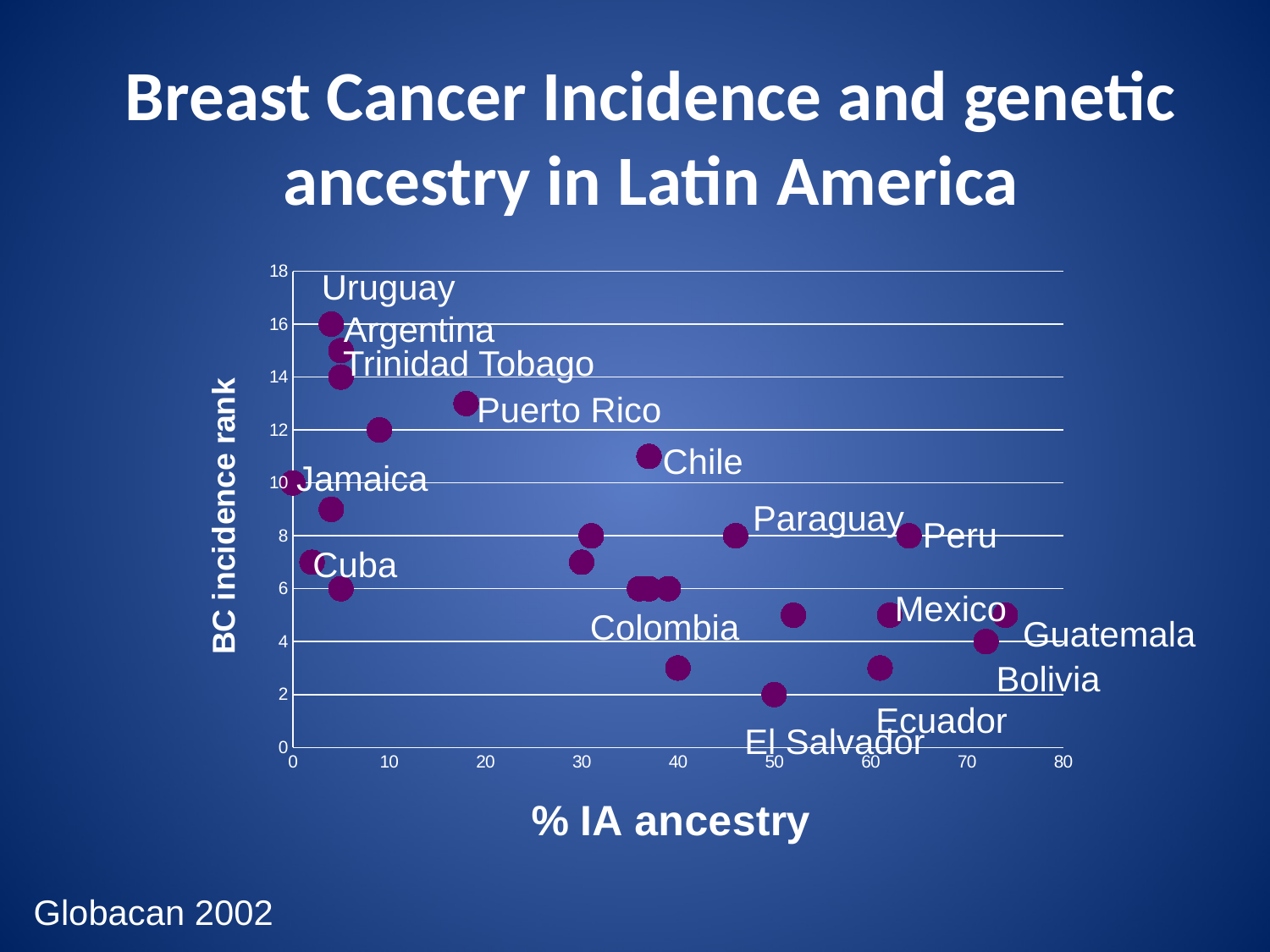
Which has the higher BC incidence rank, Uruguay or Chile? Uruguay Which labelled country has the highest BC incidence rank on the chart? Uruguay What is the title of the y axis of the chart? BC incidence rank What is the BC incidence rank of Peru? 8 As % IA ancestry increases along the x axis, does BC incidence rank generally rise or fall? Fall Is the % IA ancestry for Peru greater or less than 60? greater Is the % IA ancestry for Puerto Rico greater or less than 20? less What is the title of the x axis of the chart? % IA ancestry Is the % IA ancestry for Chile greater or less than 30? greater What kind of chart is shown on the slide? Scatter chart What is the BC incidence rank of Uruguay? 16 Which has the higher % IA ancestry, Cuba or Peru? Peru